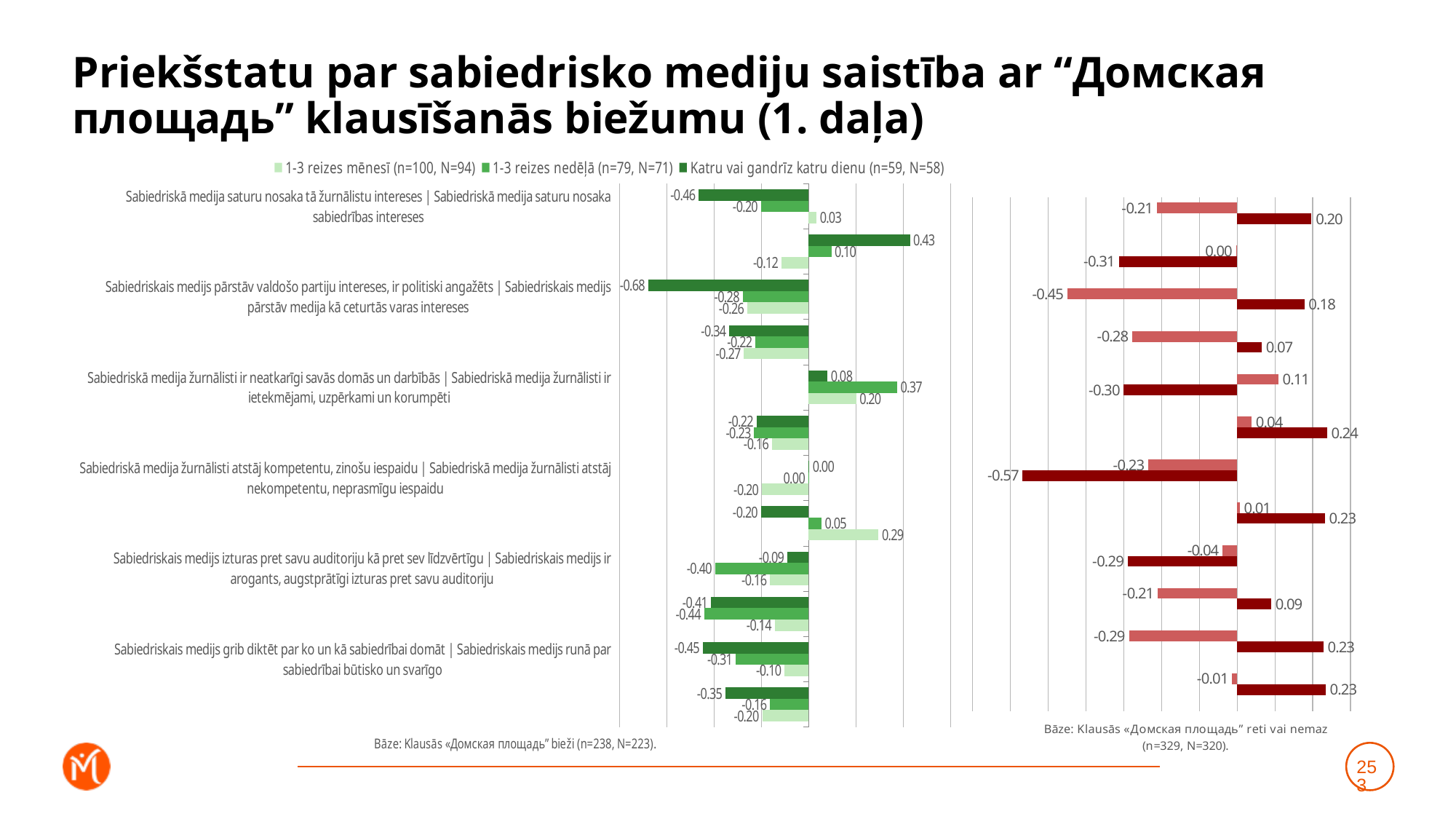
What are the three legend entries of the left chart? 1-3 reizes mēnesī (n=100, N=94); 1-3 reizes nedēļā (n=79, N=71); Katru vai gandrīz katru dienu (n=59, N=58) In the left chart, what is the value of the 'Katru vai gandrīz katru dienu' series for the first category (Sabiedriskā medija saturu nosaka tā žurnālistu intereses)? -0.46 What kind of chart is the left chart on the slide? bar chart In the left chart, for the first category, which series has the higher value: '1-3 reizes mēnesī' or 'Katru vai gandrīz katru dienu'? 1-3 reizes mēnesī What kind of chart is the right (red) chart on the slide? bar chart What is the highest value labelled in the left (green) chart? 0.43 What is the highest value labelled in the right (red) chart? 0.24 What is the lowest value labelled in the left (green) chart? -0.68 In the left chart, what is the value of the '1-3 reizes mēnesī' series for the first category (Sabiedriskā medija saturu nosaka tā žurnālistu intereses)? 0.03 What is the lowest value labelled in the right (red) chart? -0.57 In the left chart, for the first category, what is the difference between the '1-3 reizes nedēļā' value (-0.20) and the 'Katru vai gandrīz katru dienu' value (-0.46)? 0.26 How many series does the legend of the left chart list? 3